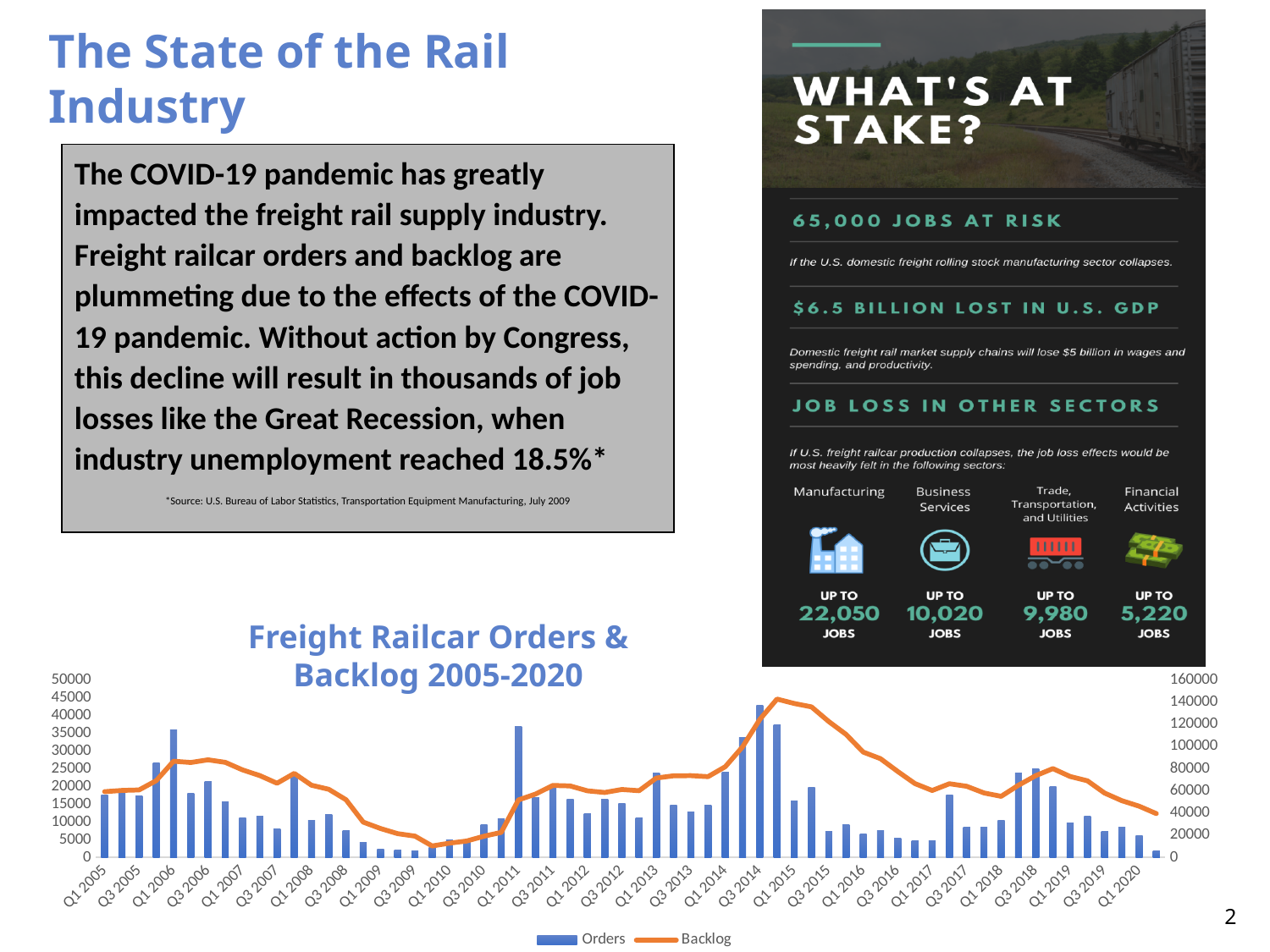
In which year does the Backlog line reach its lowest point? 2009 Which is larger, the Orders value for Q1 2005 or for Q1 2006? Q1 2006 Is the Orders value for Q1 2020 greater or less than 10000? less How many series does the legend of the 'Freight Railcar Orders & Backlog 2005-2020' chart list? 2 Which series in the 'Freight Railcar Orders & Backlog 2005-2020' chart is drawn as a line? Backlog Is the highest point of the Backlog line greater or less than 120000? greater What type of chart is 'Freight Railcar Orders & Backlog 2005-2020'? A combined bar and line chart Does the Backlog line rise or fall between Q1 2015 and Q1 2020? fall Is the Orders value for Q1 2005 greater or less than 10000? greater What is the maximum value shown on the right-hand axis of the 'Freight Railcar Orders & Backlog 2005-2020' chart? 160000